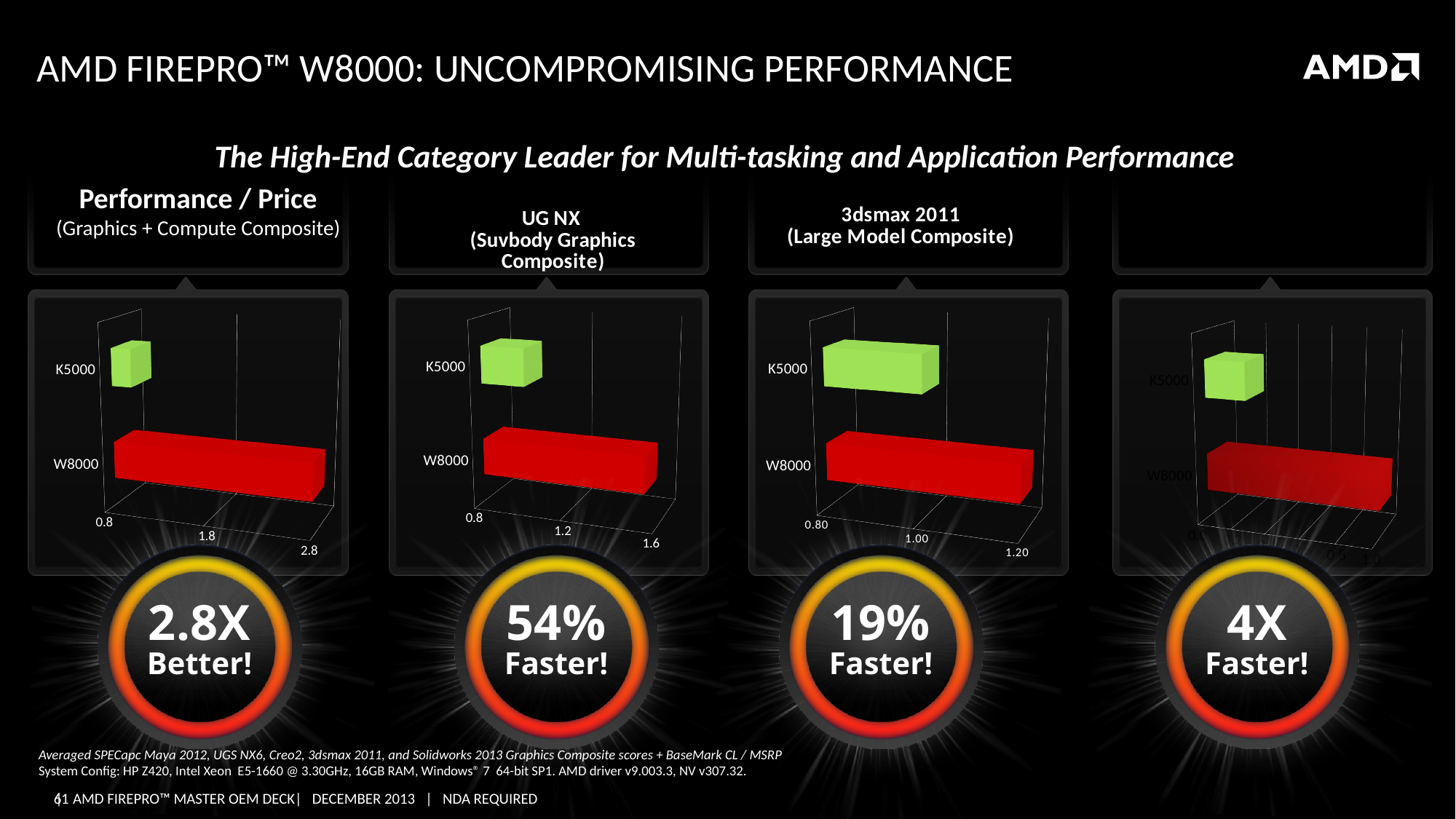
What colour is the W8000 bar in the "UG NX (Suvbody Graphics Composite)" chart? red In the "UG NX (Suvbody Graphics Composite)" chart, is the value for K5000 greater or less than 1.2? less In the rightmost chart on the slide, which product has the longer bar, K5000 or W8000? W8000 In the "Performance / Price" chart, which product has the longer bar, W8000 or K5000? W8000 In the "3dsmax 2011 (Large Model Composite)" chart, which product has the higher value, K5000 or W8000? W8000 What is the highest axis tick shown on the "Performance / Price" chart? 2.8 In the "Performance / Price" chart, is the value for K5000 greater or less than 1.8? less In the "3dsmax 2011 (Large Model Composite)" chart, is the value for W8000 greater or less than 1.00? greater What kind of chart is the "Performance / Price" chart? bar chart How many products are compared in the "UG NX (Suvbody Graphics Composite)" chart? 2